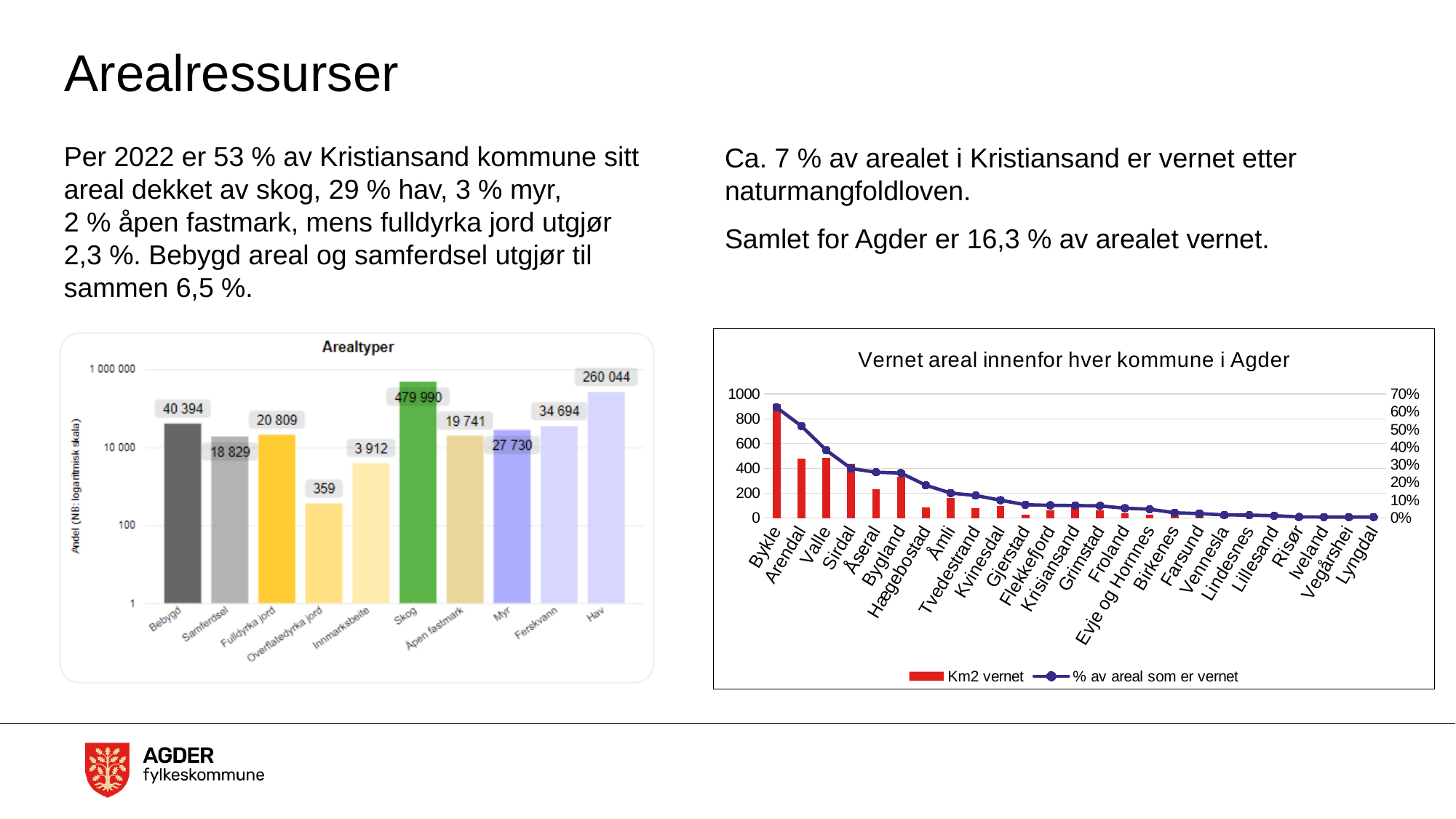
In the chart 'Vernet areal innenfor hver kommune i Agder', is the Km2 vernet value for Bykle greater or less than 800? greater In the chart 'Vernet areal innenfor hver kommune i Agder', which municipality has the highest Km2 vernet? Bykle How many series does the legend list in the chart 'Vernet areal innenfor hver kommune i Agder'? 2 In the Arealtyper chart, which category has the lowest value? Overflatedyrka jord In the Arealtyper chart, what is the difference between Bebygd and Samferdsel? 21 565 In the Arealtyper chart, which category has the highest value? Skog In the chart 'Vernet areal innenfor hver kommune i Agder', does the '% av areal som er vernet' line rise or fall from left to right? fall How many categories are shown in the Arealtyper chart? 10 In the Arealtyper chart, what is the value for Skog? 479 990 In the Arealtyper chart, what is the value for Overflatedyrka jord? 359 In the Arealtyper chart, what is the value for Hav? 260 044 In the Arealtyper chart, which is larger, Myr or Ferskvann? Ferskvann